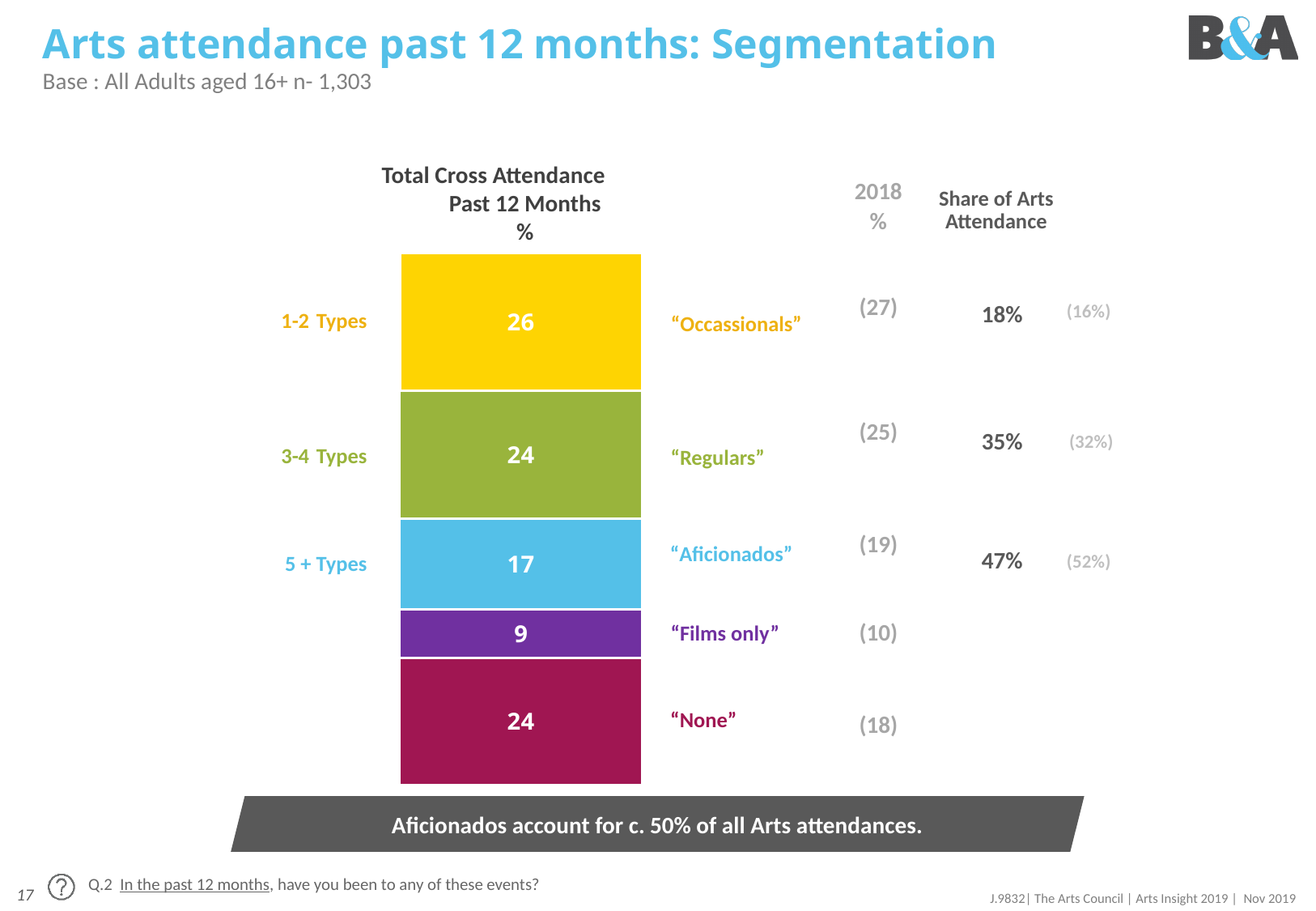
What is the total of all segments in the stacked bar? 100 How many segments make up the stacked bar? 5 What percentage of adults are in the "Films only" segment? 9 What is the difference between the "Regulars" value and the "Aficionados" value in the stacked bar? 7 What percentage of adults fall into the "Aficionados" segment (5 + Types)? 17 Which segment has the largest value in the stacked bar? "Occassionals" What is the Share of Arts Attendance for "Aficionados"? 47% What was the 2018 % value for the "None" segment? (18) Which is larger: the "Occassionals" value or the "Aficionados" value? "Occassionals" Which segment has the smallest value in the stacked bar? "Films only" What percentage of adults fall into the "Occassionals" segment (1-2 Types) in the Total Cross Attendance Past 12 Months bar? 26 What type of chart is shown on the slide? Stacked bar chart